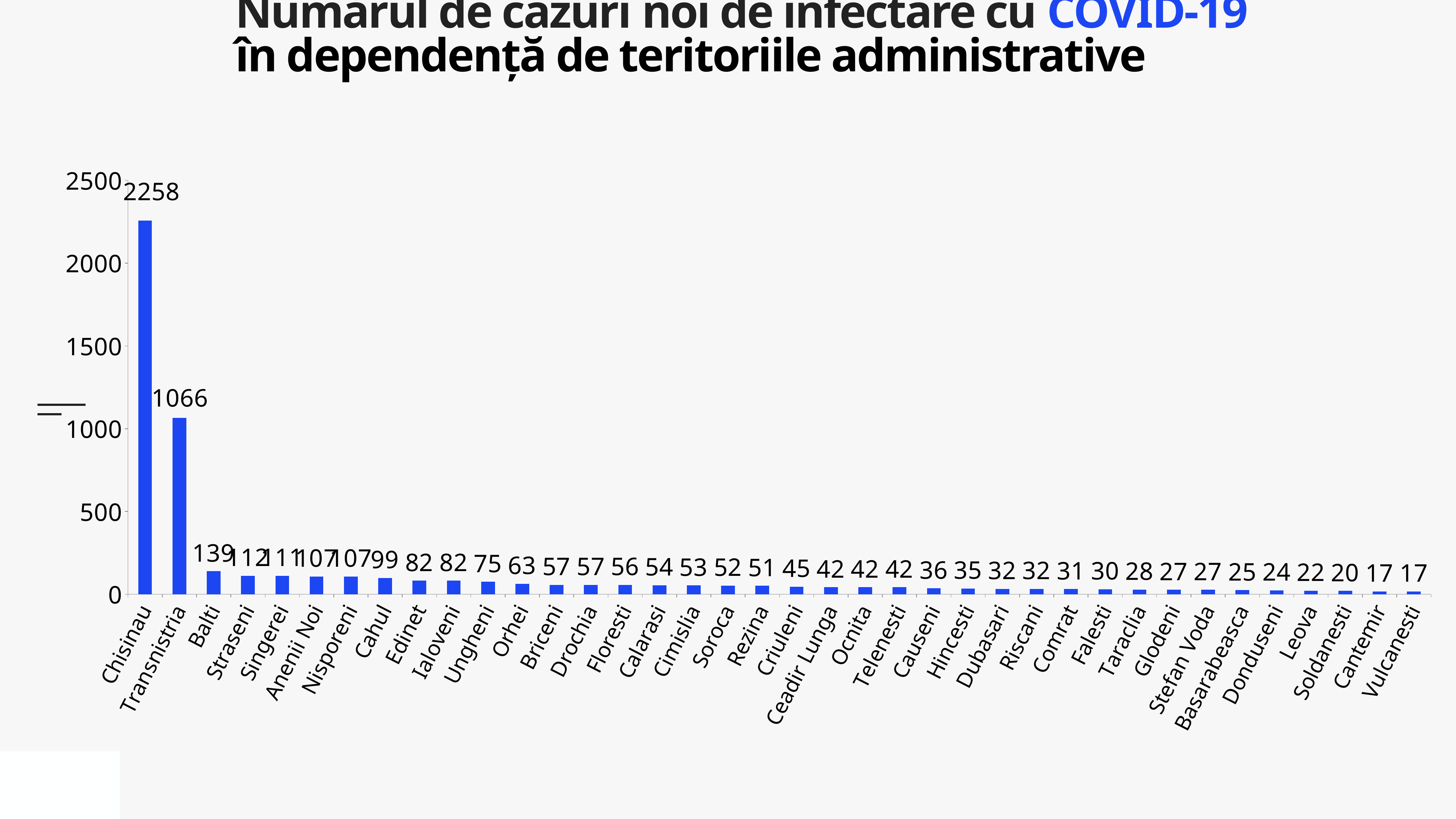
What is the value for Chisinau? 2258 Which territory has the highest number of new cases? Chisinau Which is larger, the value for Ungheni or the value for Orhei? Ungheni What is the value for Orhei? 63 What is the value for Leova? 22 What is the value for Balti? 139 Do the values rise or fall from left to right along the x axis? fall What kind of chart is shown on the slide? bar chart What is the difference between the values for Chisinau and Transnistria? 1192 What is the value for Transnistria? 1066 How many territories are shown on the x axis? 38 Is the value for Transnistria greater or less than 1000? greater